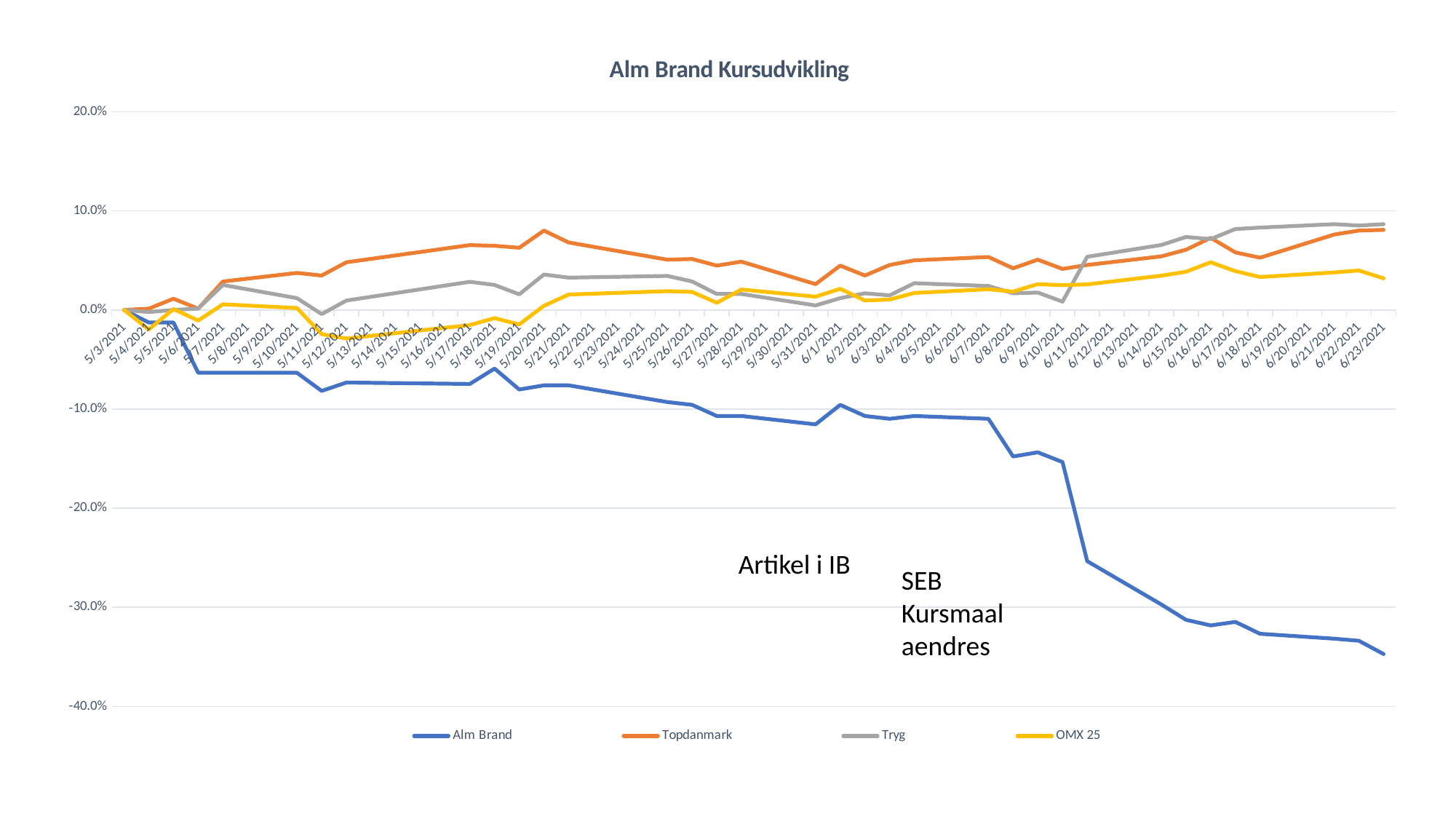
What is the title of the chart? Alm Brand Kursudvikling Does the Alm Brand line rise or fall from 5/3/2021 to 6/23/2021? fall How many series does the legend list? 4 Is the value for Topdanmark on 5/21/2021 greater or less than 10.0%? less Is the value for Alm Brand on 6/10/2021 greater or less than -10.0%? less Is the value for Tryg on 6/23/2021 greater or less than 0.0%? greater Which series has the lowest value on 6/23/2021? Alm Brand Which series is plotted in blue? Alm Brand What kind of chart is shown on the slide? line chart How many dates are shown on the x axis? 52 On 6/23/2021, which is larger: the value for OMX 25 or the value for Alm Brand? OMX 25